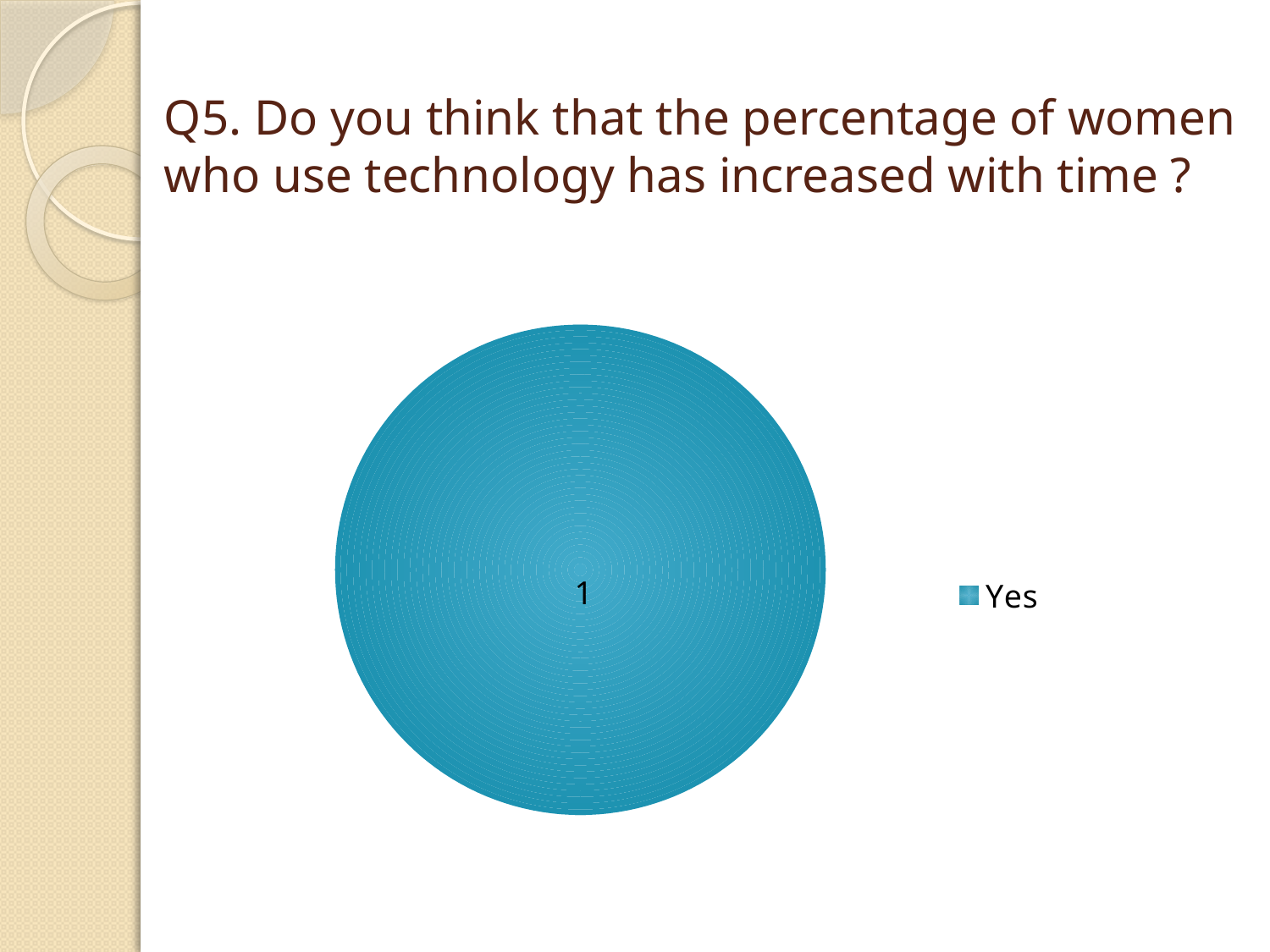
What kind of chart is shown on the slide? pie chart What colour is the Yes slice in the pie chart? blue What is the data label shown on the pie slice? 1 What category does the legend entry name? Yes Which category has the largest slice in the pie chart? Yes How many entries does the legend list? 1 How many slices does the pie chart have? 1 What is the value for Yes in the pie chart? 1 What share of the pie does the Yes slice take up? 100%